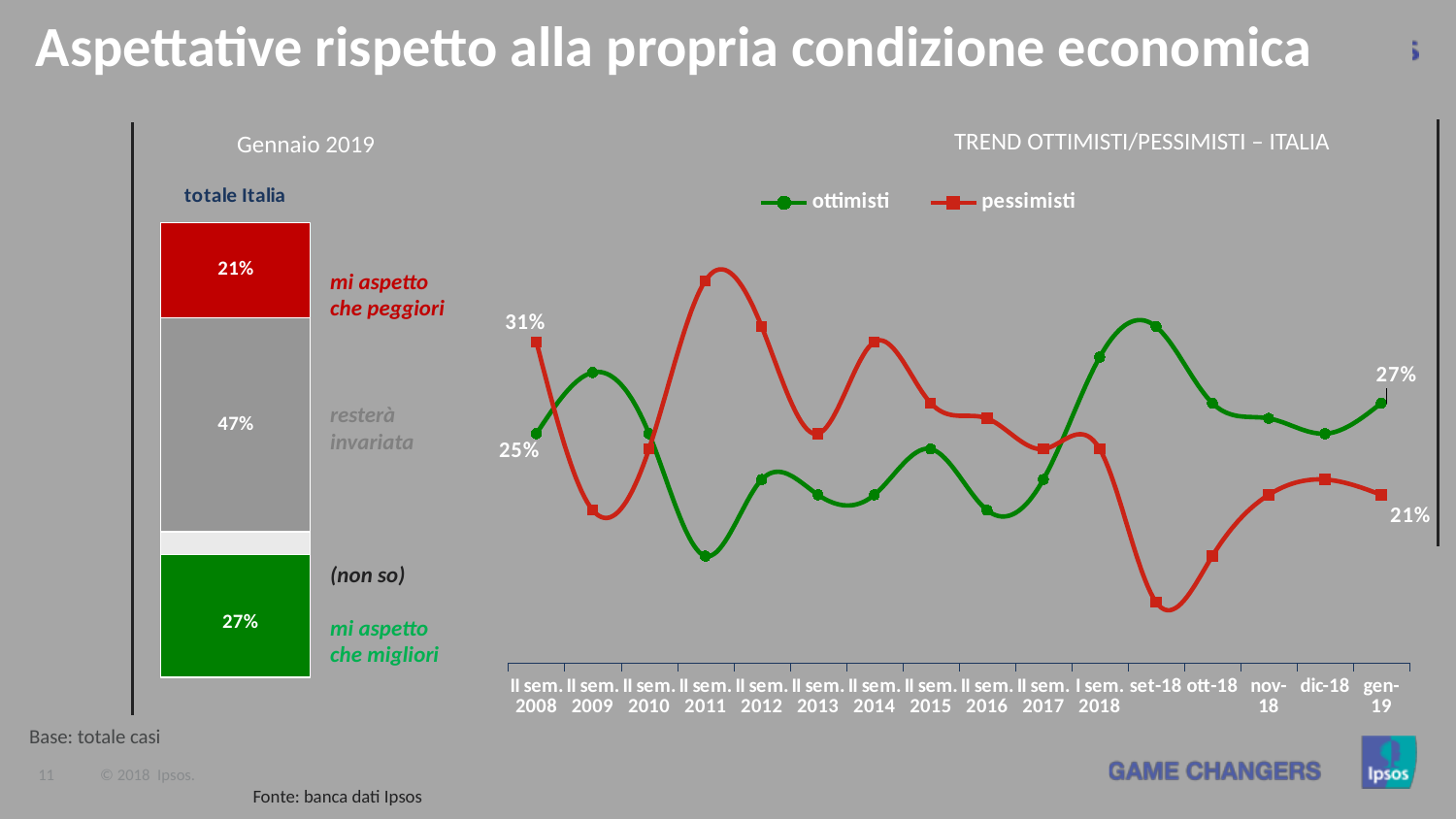
In the stacked bar chart on the left (Gennaio 2019), what percentage corresponds to 'resterà invariata'? 47% In the chart 'TREND OTTIMISTI/PESSIMISTI – ITALIA', which series has the higher value at gen-19? ottimisti In the chart 'TREND OTTIMISTI/PESSIMISTI – ITALIA', what is the value for ottimisti at gen-19? 27% In the chart 'TREND OTTIMISTI/PESSIMISTI – ITALIA', what colour is the line for pessimisti? red In the stacked bar chart on the left (Gennaio 2019), what percentage corresponds to 'mi aspetto che peggiori'? 21% In the stacked bar chart on the left (Gennaio 2019), which is larger: 'mi aspetto che migliori' or 'mi aspetto che peggiori'? mi aspetto che migliori In the stacked bar chart on the left (Gennaio 2019), what is the difference between 'mi aspetto che migliori' and 'mi aspetto che peggiori'? 6 percentage points What kind of chart is 'TREND OTTIMISTI/PESSIMISTI – ITALIA'? line chart In the chart 'TREND OTTIMISTI/PESSIMISTI – ITALIA', what is the value for pessimisti at II sem. 2008? 31% In the chart 'TREND OTTIMISTI/PESSIMISTI – ITALIA', how many series does the legend list? 2 In the stacked bar chart on the left (Gennaio 2019), what percentage corresponds to 'mi aspetto che migliori'? 27% In the stacked bar chart on the left (Gennaio 2019), which labelled response has the largest share? resterà invariata